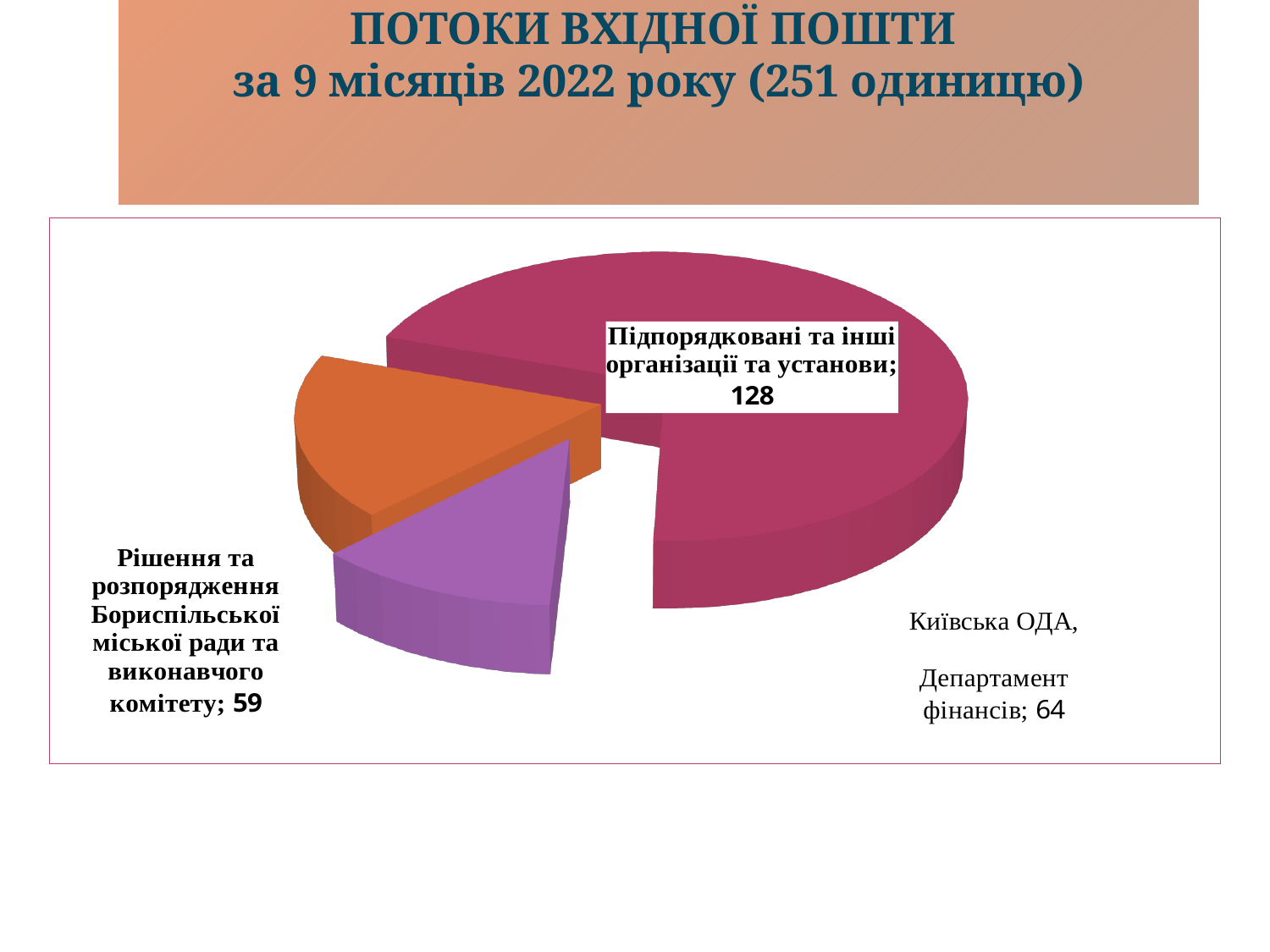
What is the value for "Рішення та розпорядження Бориспільської міської ради та виконавчого комітету"? 59 What is the value for "Підпорядковані та інші організації та установи"? 128 What is the value for "Київська ОДА, Департамент фінансів"? 64 What type of chart is shown on the slide? pie chart Which category has the largest slice of the pie? Підпорядковані та інші організації та установи What is the total number of units stated in the chart title? 251 What is the difference between the value for "Київська ОДА, Департамент фінансів" and the value for "Рішення та розпорядження Бориспільської міської ради та виконавчого комітету"? 5 What is the title of the chart? ПОТОКИ ВХІДНОЇ ПОШТИ за 9 місяців 2022 року (251 одиницю) How many slices does the pie chart have? 3 Which is larger: the value for "Київська ОДА, Департамент фінансів" or the value for "Рішення та розпорядження Бориспільської міської ради та виконавчого комітету"? Київська ОДА, Департамент фінансів What is the difference between the value for "Підпорядковані та інші організації та установи" and the value for "Київська ОДА, Департамент фінансів"? 64